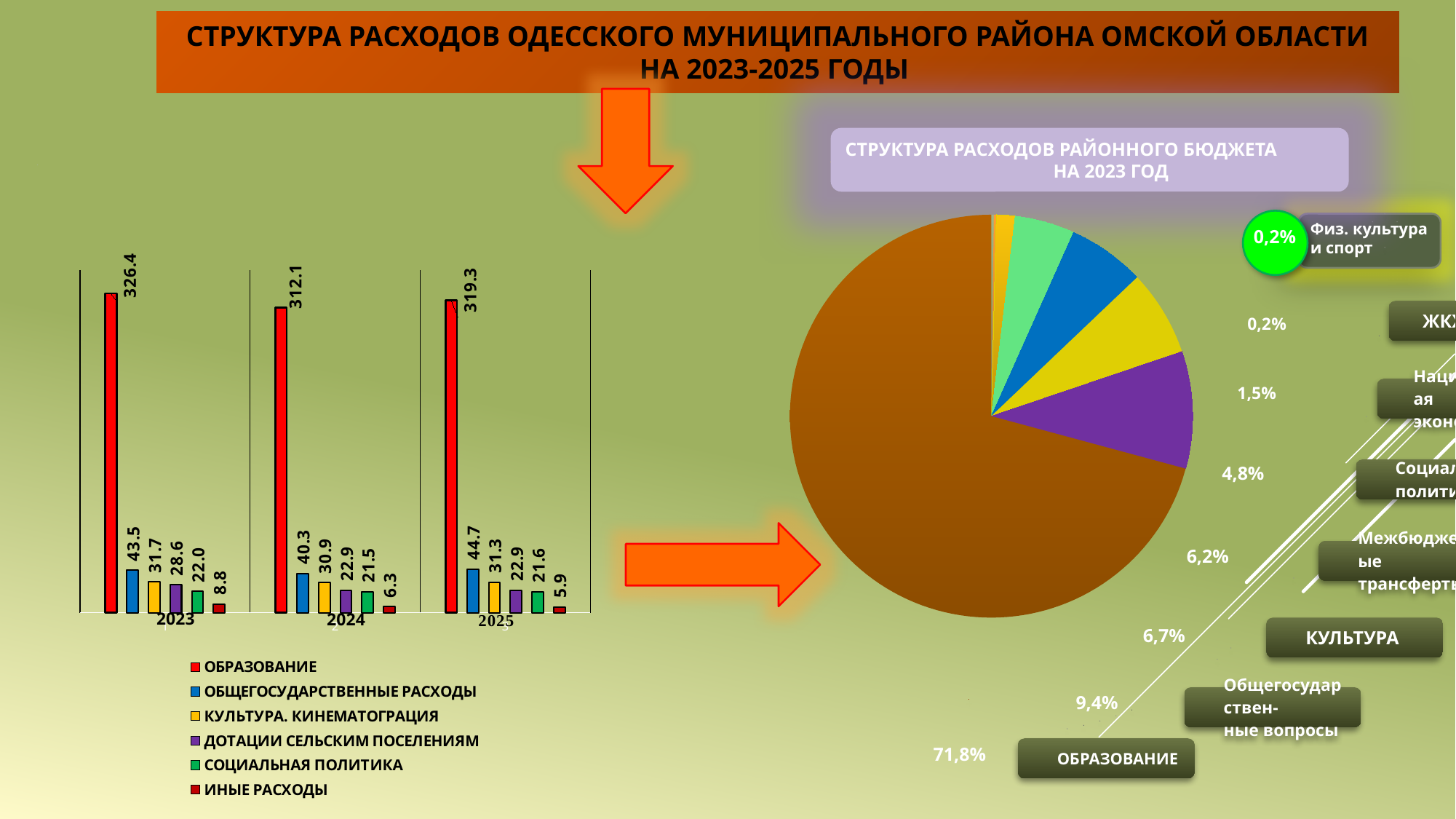
In the bar chart on the left, how many series does the legend list? 6 In the bar chart on the left, which year has the lowest value for ОБРАЗОВАНИЕ? 2024 In the bar chart on the left, how many years are shown on the x axis? 3 What type of chart is shown on the right side of the slide? pie chart In the pie chart titled СТРУКТУРА РАСХОДОВ РАЙОННОГО БЮДЖЕТА НА 2023 ГОД, what share does ОБРАЗОВАНИЕ have? 71,8% In the bar chart on the left, does the value for ИНЫЕ РАСХОДЫ rise or fall from 2023 to 2025? fall In the bar chart on the left, is the value for КУЛЬТУРА. КИНЕМАТОГРАЦИЯ in 2023 larger or smaller than in 2024? larger In the bar chart on the left, what is the value for ОБЩЕГОСУДАРСТВЕННЫЕ РАСХОДЫ in 2025? 44.7 In the pie chart titled СТРУКТУРА РАСХОДОВ РАЙОННОГО БЮДЖЕТА НА 2023 ГОД, what share does КУЛЬТУРА have? 6,7% In the bar chart on the left, what is the value for ОБРАЗОВАНИЕ in 2023? 326.4 In the bar chart on the left, what is the difference between the ОБРАЗОВАНИЕ values for 2023 and 2025? 7.1 In the bar chart on the left, what is the value for ИНЫЕ РАСХОДЫ in 2024? 6.3